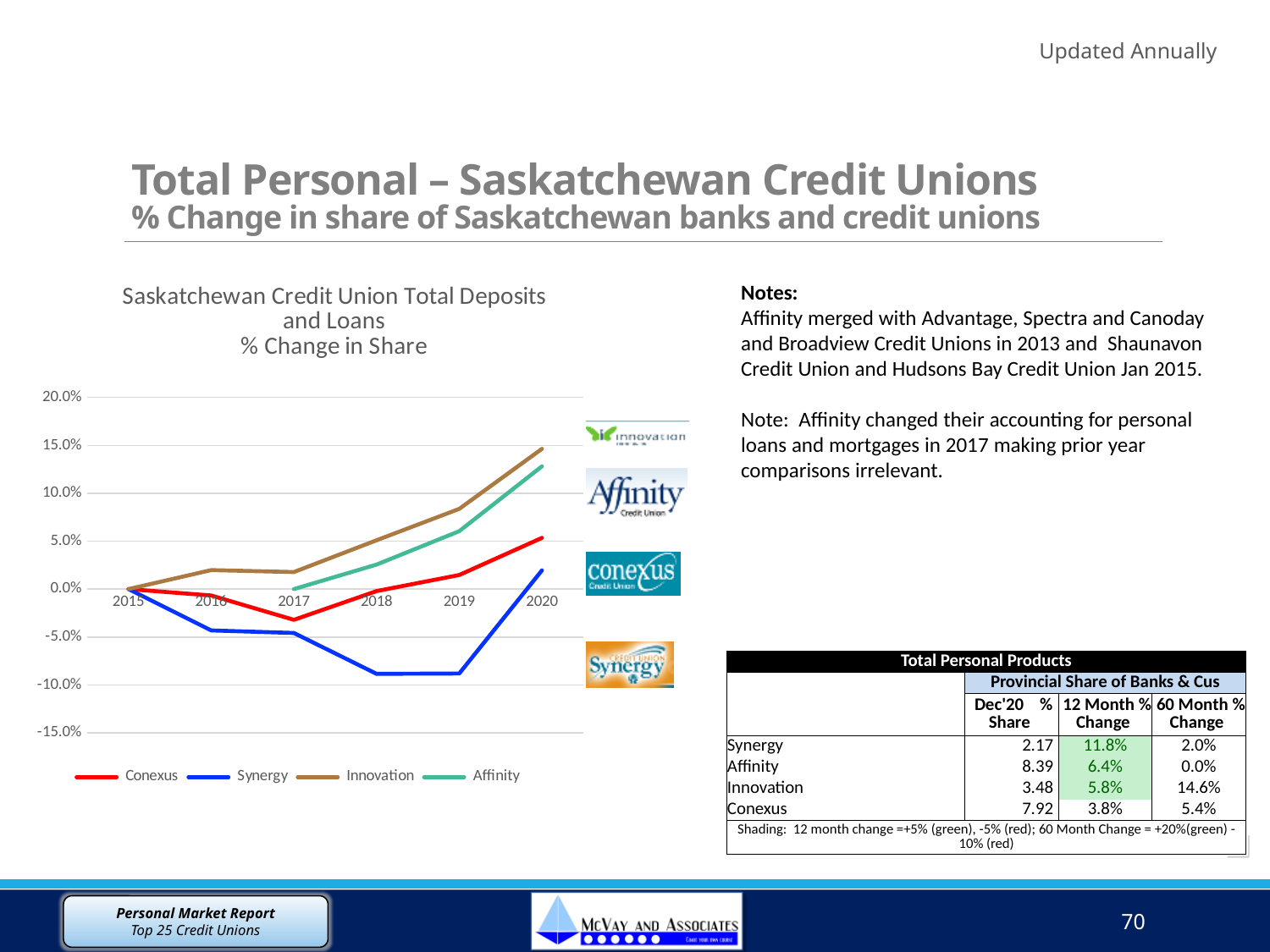
What kind of chart is shown on the slide? line chart Is the value for Conexus in 2017 greater or less than 0.0%? less Does the Innovation line rise or fall from 2017 to 2020? rises How many years are plotted along the x axis of the chart? 6 How many series does the chart legend list? 4 What colour is the Synergy line in the chart? blue Is the value for Synergy in 2018 greater or less than -5.0%? less Which series has the lowest value in 2020? Synergy Which series reaches the lowest point anywhere on the chart? Synergy Which series has the highest value in 2020? Innovation In 2019, which is larger: the value for Innovation or the value for Conexus? Innovation Is the value for Innovation in 2020 greater or less than 10.0%? greater